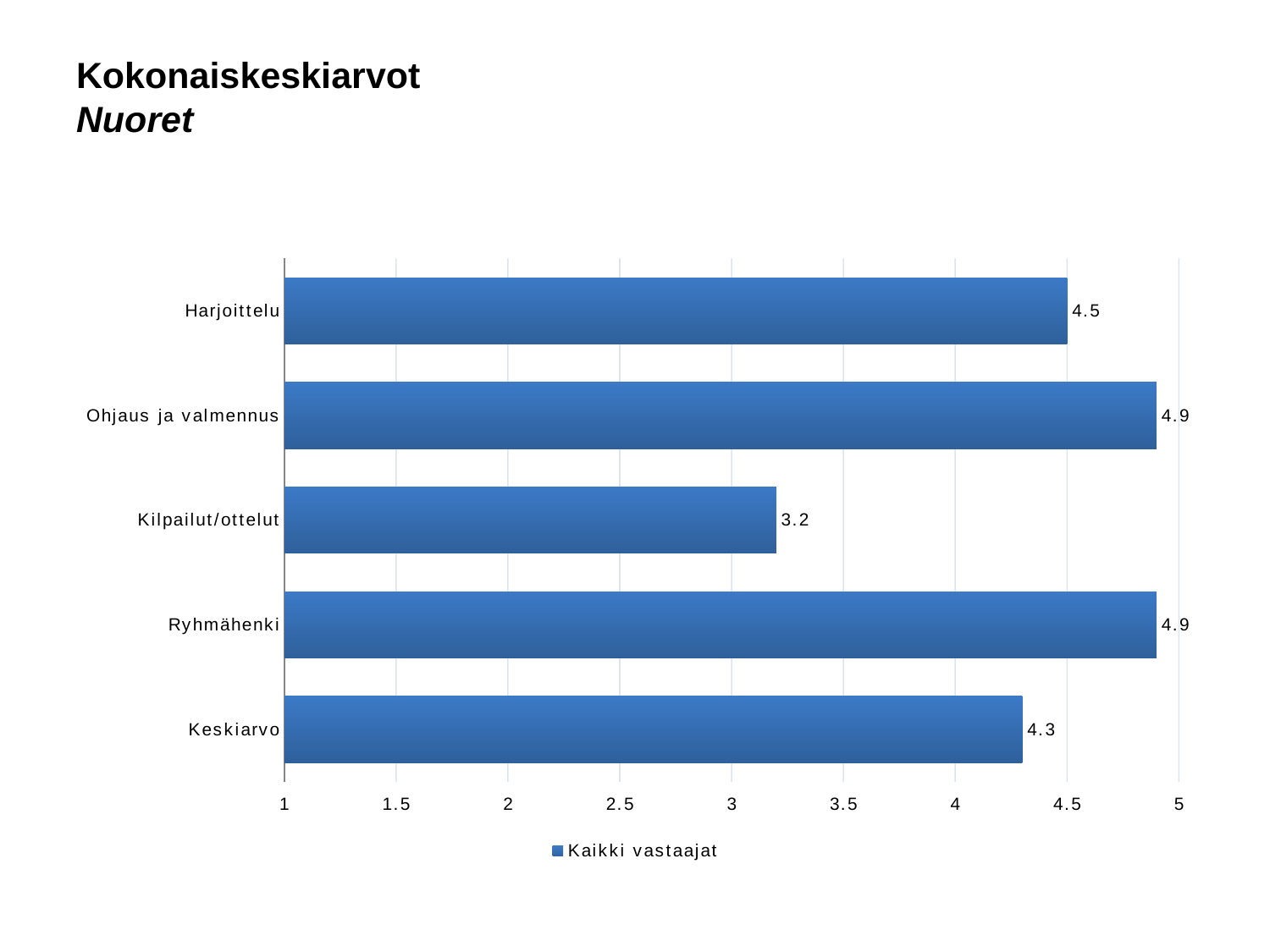
What is the value for Keskiarvo? 4.3 Which is larger, the value for Harjoittelu or the value for Kilpailut/ottelut? Harjoittelu Is the value for Kilpailut/ottelut greater or less than 3.5? less What is the value for Ohjaus ja valmennus? 4.9 What series name does the legend show? Kaikki vastaajat How many categories are shown in the chart? 5 What kind of chart is shown on the slide? bar chart What is the value for Harjoittelu? 4.5 What is the difference between the values for Harjoittelu and Keskiarvo? 0.2 Which category has the lowest value? Kilpailut/ottelut What is the value for Kilpailut/ottelut? 3.2 What is the difference between the values for Ryhmähenki and Kilpailut/ottelut? 1.7